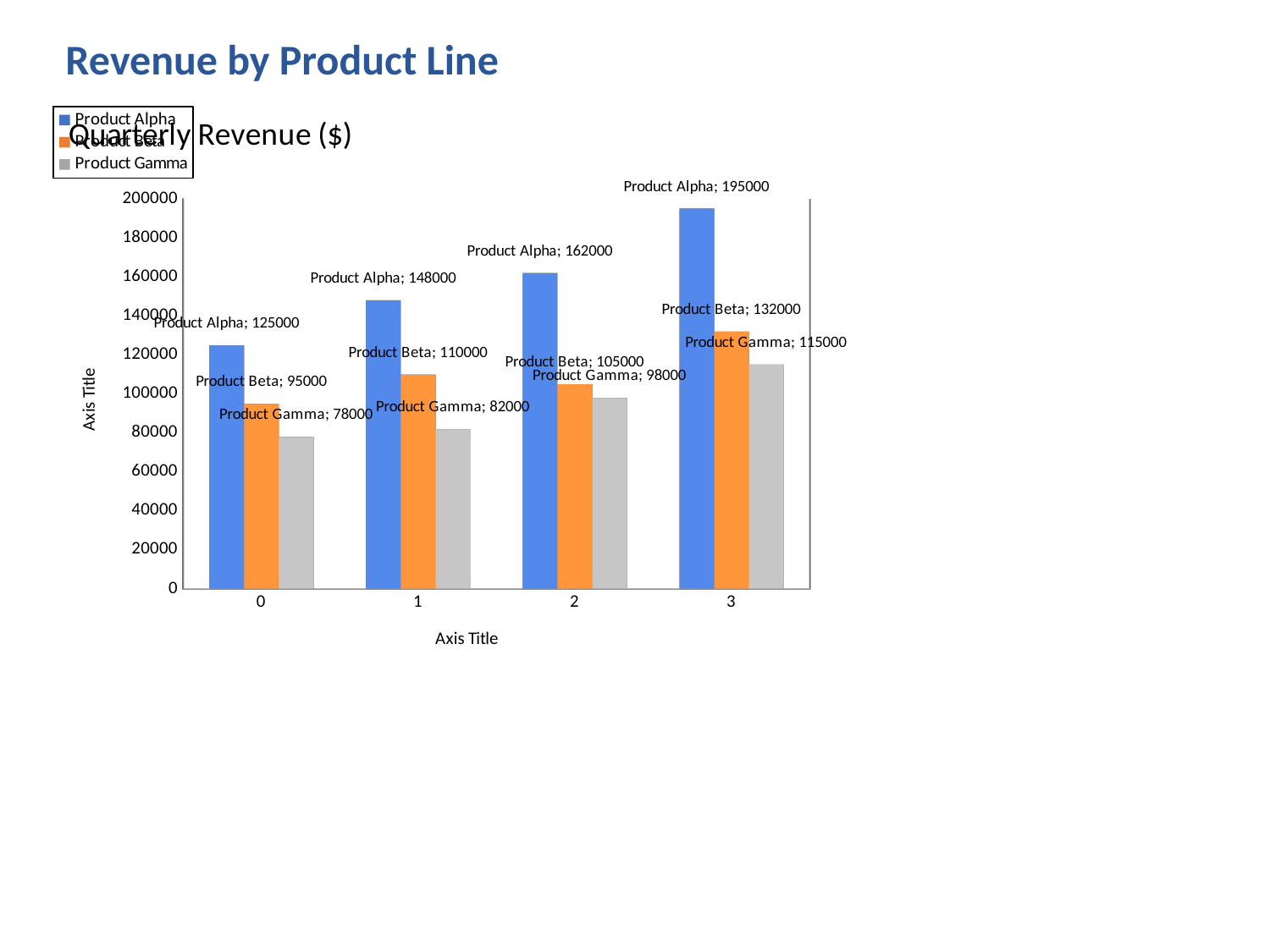
What is the value for Product Beta at category 1? 110000 What is the difference between Product Alpha and Product Beta at category 2? 57000 What is the value for Product Alpha at category 3? 195000 Which is larger at category 3: Product Beta or Product Gamma? Product Beta What type of chart is shown on the slide? bar chart What is the title of the chart? Quarterly Revenue ($) What is the value for Product Gamma at category 0? 78000 How many series does the legend list? 3 At which category is Product Gamma lowest? 0 At which category is Product Alpha highest? 3 Do the Product Alpha values rise or fall from category 0 to category 3? rise How many categories are shown on the x axis? 4